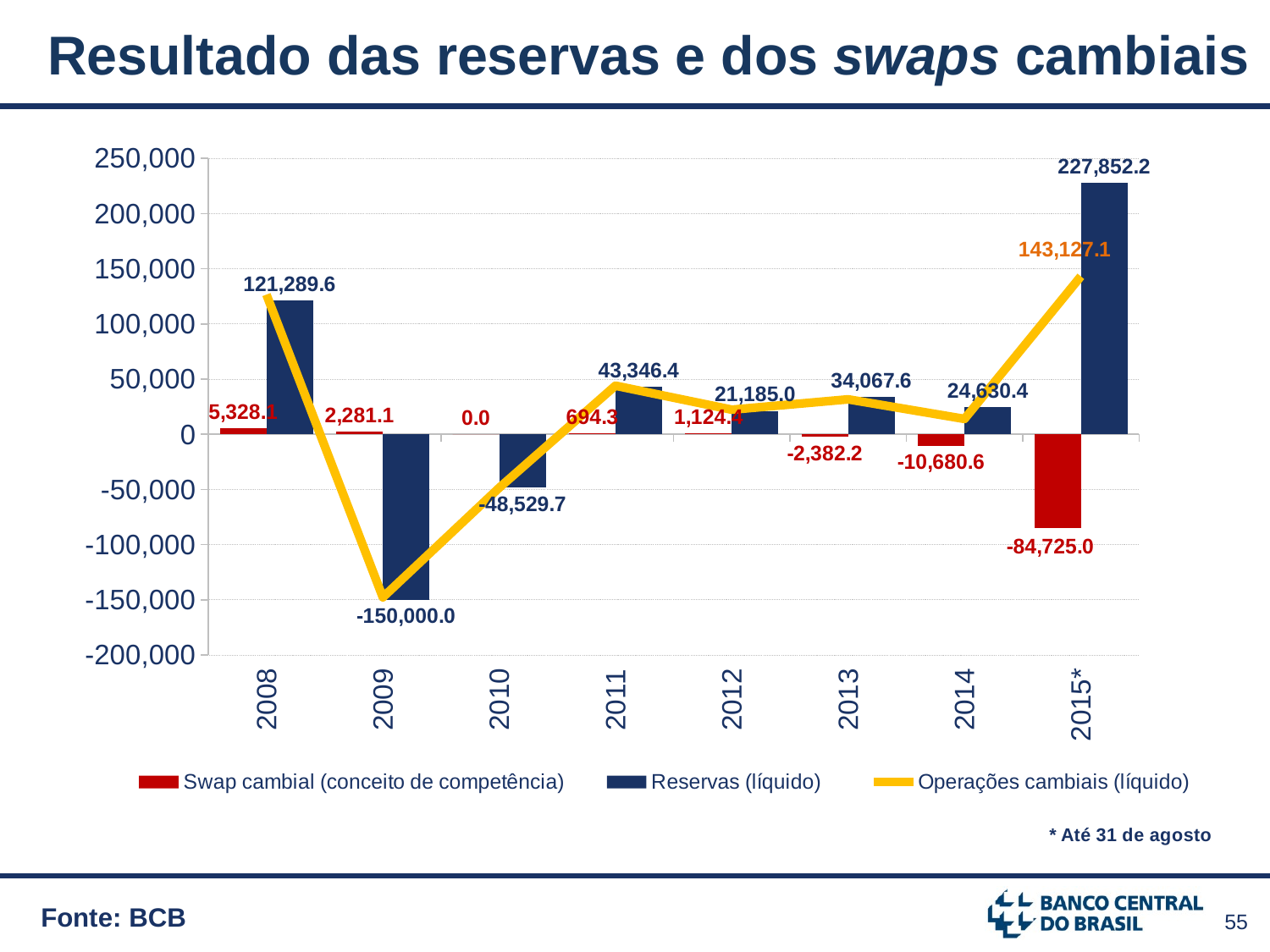
How many series does the legend list? 3 What is the value of Operações cambiais (líquido) for 2015*? 143,127.1 What is the difference between Reservas (líquido) in 2015* and in 2008? 106,562.6 What is the value of Reservas (líquido) for 2010? -48,529.7 Which year has the lowest value for Reservas (líquido)? 2009 Which series is drawn as a yellow line? Operações cambiais (líquido) Which is larger, Reservas (líquido) in 2013 or in 2014? 2013 Which year has the highest value for Swap cambial (conceito de competência)? 2008 How many years are shown on the x axis? 8 Is the value of Operações cambiais (líquido) for 2009 greater or less than -100,000? less What is the value of Swap cambial (conceito de competência) for 2014? -10,680.6 What is the value of Reservas (líquido) for 2015*? 227,852.2